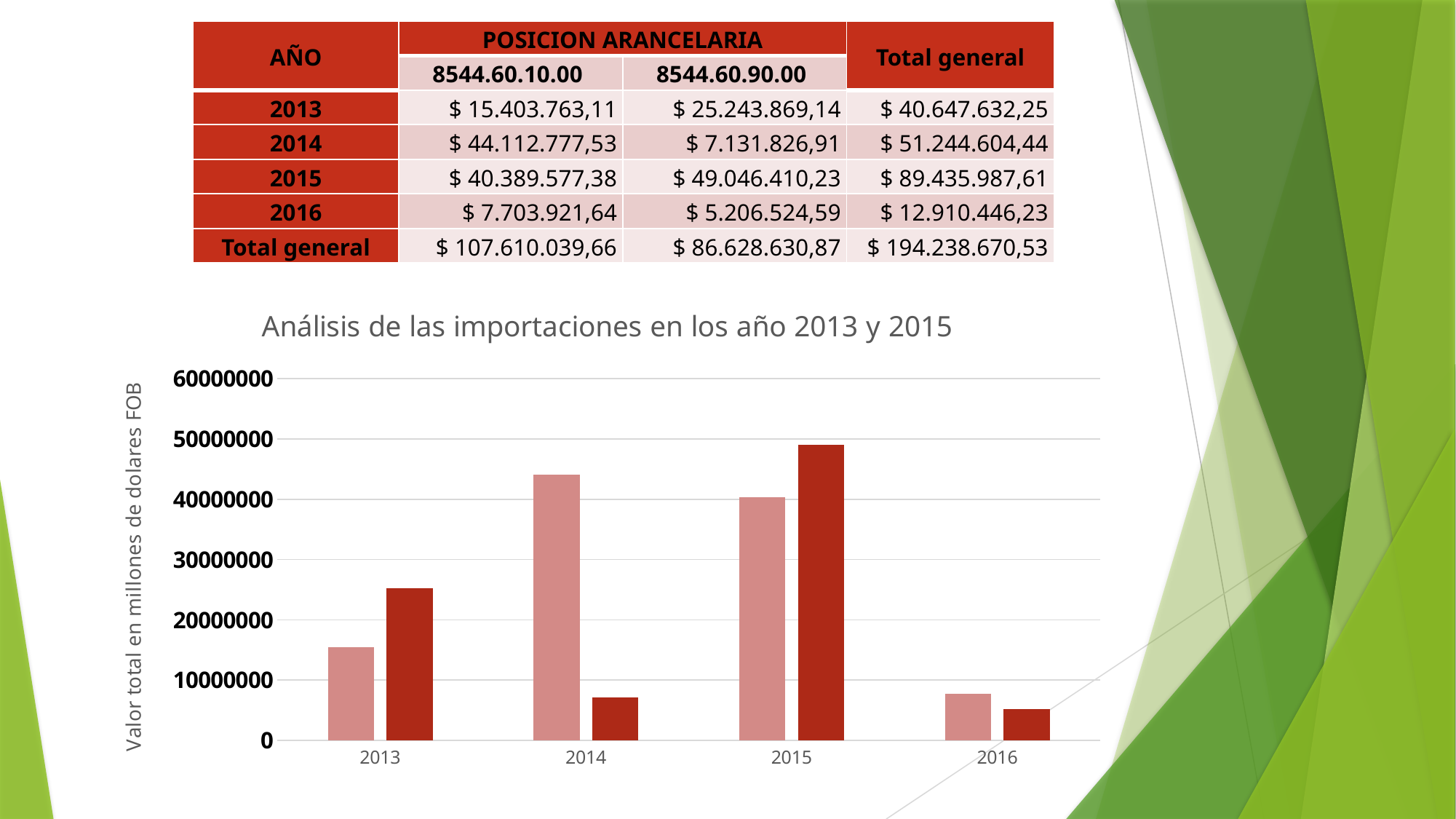
What is the label on the vertical axis of the chart? Valor total en millones de dolares FOB Which year has the tallest bar in the chart? 2015 How many years are shown on the x axis of the chart? 4 What is the title of the chart? Análisis de las importaciones en los año 2013 y 2015 In 2013, which bar is taller, the light pink bar or the dark red bar? the dark red bar Is the value of the light pink bar for 2014 greater or less than 40000000? greater Do the light pink bars rise or fall from 2015 to 2016? fall In 2014, which bar is taller, the light pink bar or the dark red bar? the light pink bar Is the value of the light pink bar for 2013 greater or less than 20000000? less Is the value of the dark red bar for 2014 greater or less than 10000000? less What kind of chart is shown on the slide? bar chart